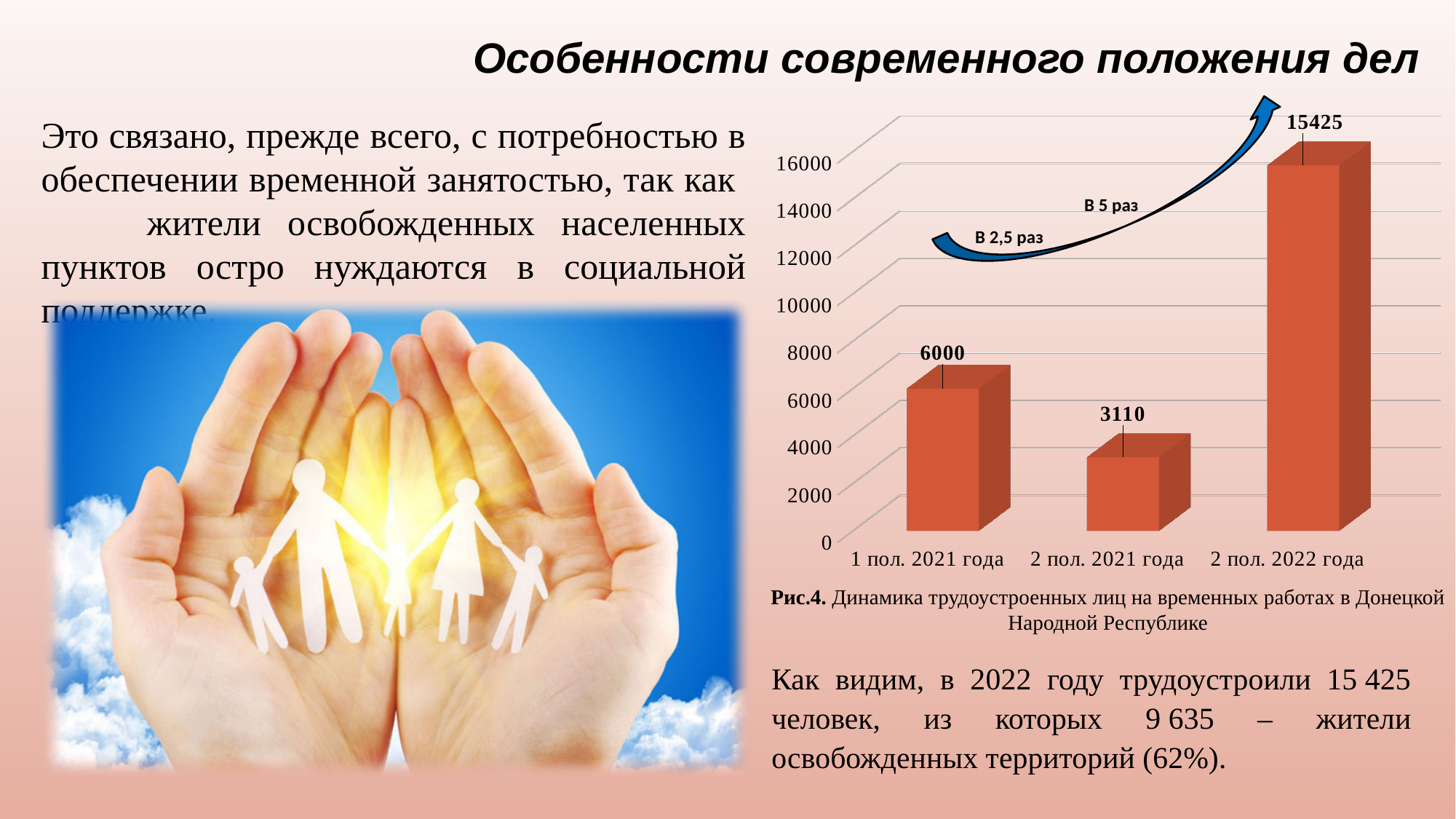
What is the difference between the values for 2 пол. 2022 года and 1 пол. 2021 года? 9425 Is the value for 2 пол. 2022 года greater or less than 14000? greater What is the difference between the values for 1 пол. 2021 года and 2 пол. 2021 года? 2890 What kind of chart is shown on the slide? bar chart Which category has the highest value? 2 пол. 2022 года What is the figure caption of the chart? Рис.4. Динамика трудоустроенных лиц на временных работах в Донецкой Народной Республике How many categories are shown on the x axis? 3 Which is larger, the value for 1 пол. 2021 года or 2 пол. 2021 года? 1 пол. 2021 года What is the value for 2 пол. 2022 года? 15425 What is the value for 1 пол. 2021 года? 6000 Which category has the lowest value? 2 пол. 2021 года What is the value for 2 пол. 2021 года? 3110